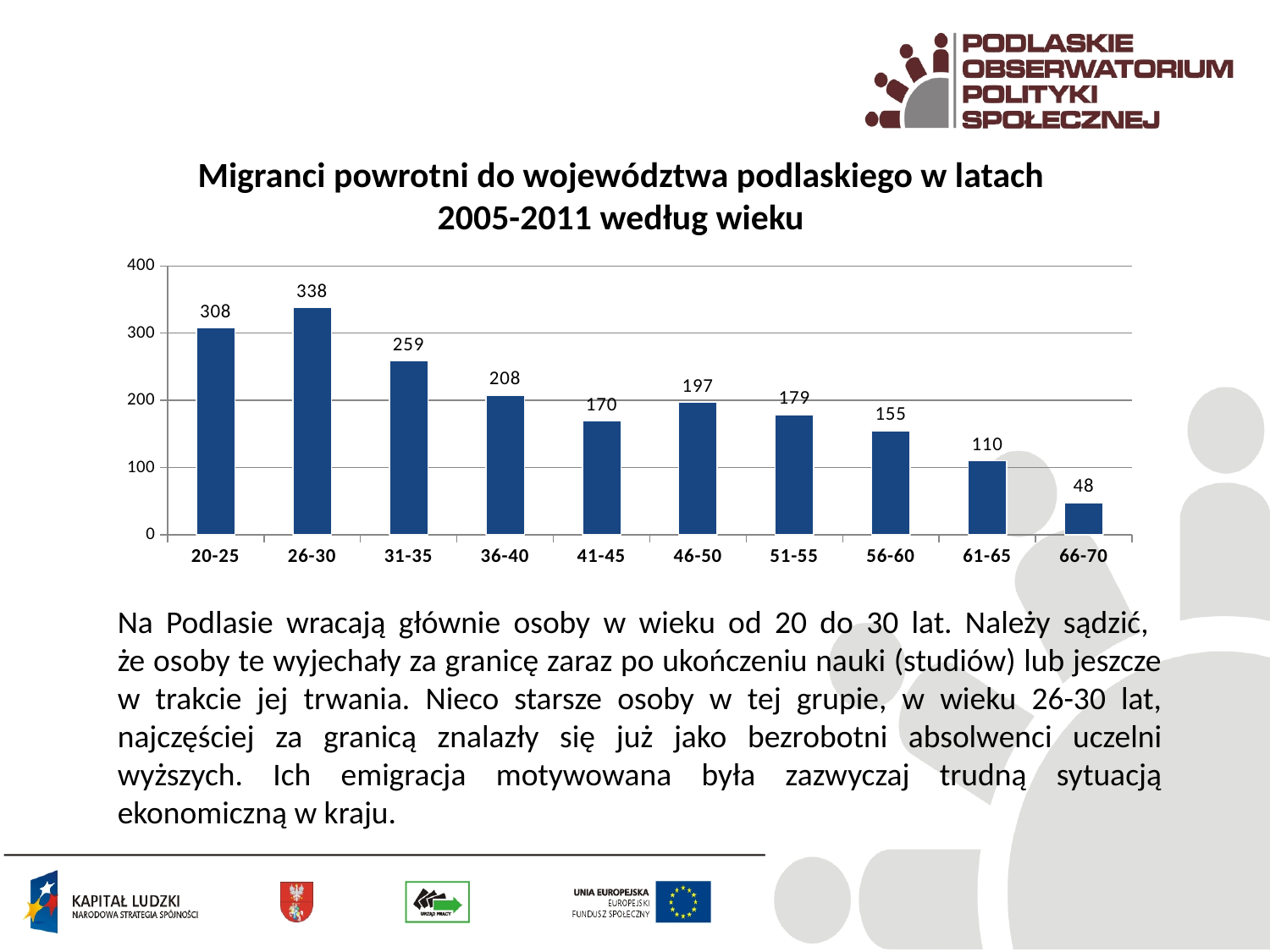
Which is larger, the value for 41-45 or the value for 51-55? 51-55 What is the difference between the values for the 56-60 and 61-65 age groups? 45 What is the value for the 26-30 age group? 338 Which age group has the lowest value? 66-70 What kind of chart is shown on the slide? bar chart What is the value for the 66-70 age group? 48 Which age group has the highest value? 26-30 What is the value for the 46-50 age group? 197 How many age groups are shown on the x axis? 10 What is the title of the chart? Migranci powrotni do województwa podlaskiego w latach 2005-2011 według wieku Is the value for the 36-40 age group greater or less than 200? greater What is the difference between the values for the 20-25 and 31-35 age groups? 49